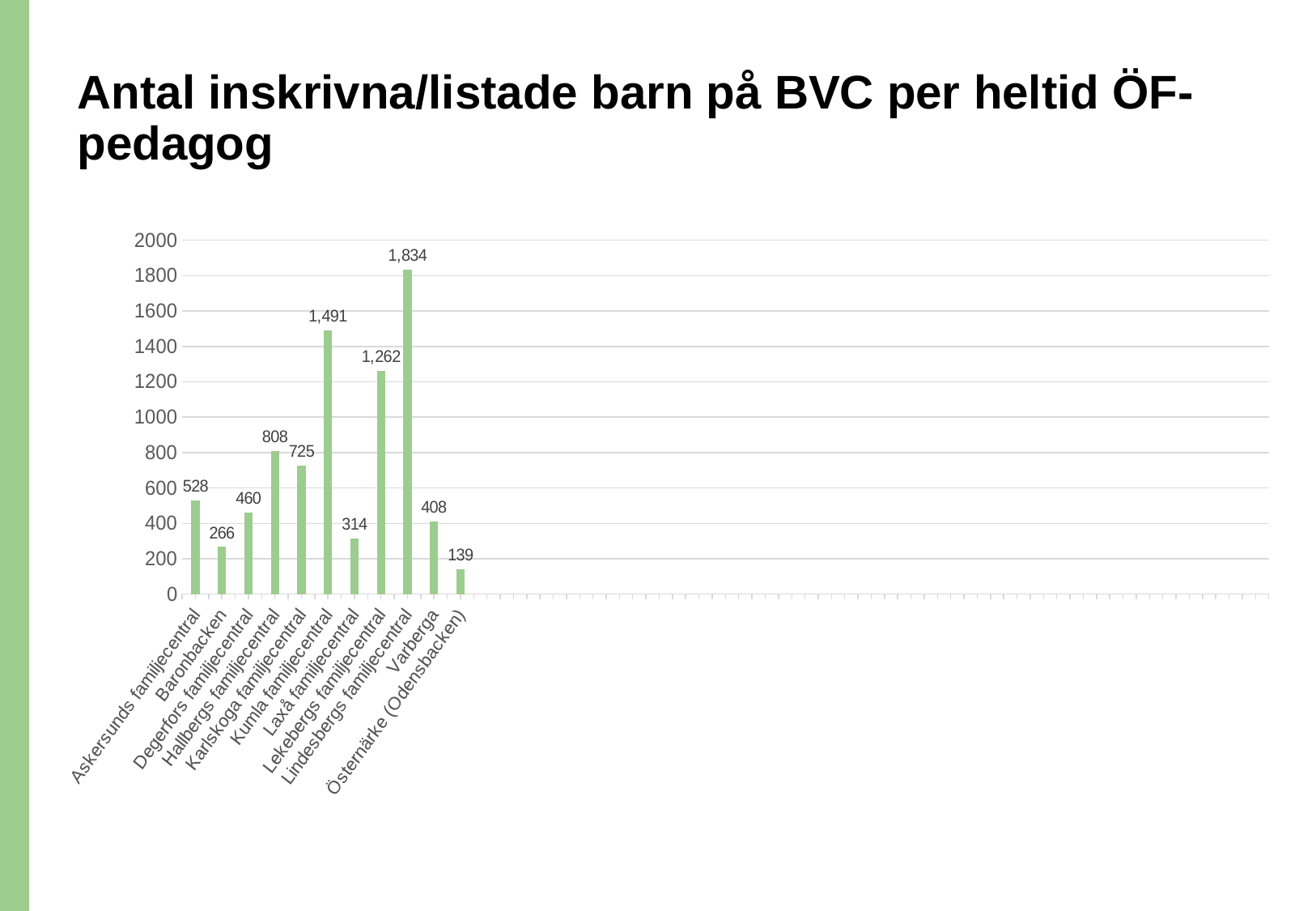
What is the value for Baronbacken? 266 What is the value for Östernärke (Odensbacken)? 139 What is the difference between the values for Lindesbergs familjecentral and Lekebergs familjecentral? 572 How many categories are shown on the x axis? 11 Which category has the highest value? Lindesbergs familjecentral Which category has the lowest value? Östernärke (Odensbacken) What is the difference between the values for Hallbergs familjecentral and Karlskoga familjecentral? 83 Which is larger, the value for Askersunds familjecentral or the value for Degerfors familjecentral? Askersunds familjecentral What is the value for Kumla familjecentral? 1,491 Is the value for Laxå familjecentral greater or less than 400? less What is the value for Varberga? 408 What kind of chart is shown on the slide? Bar chart